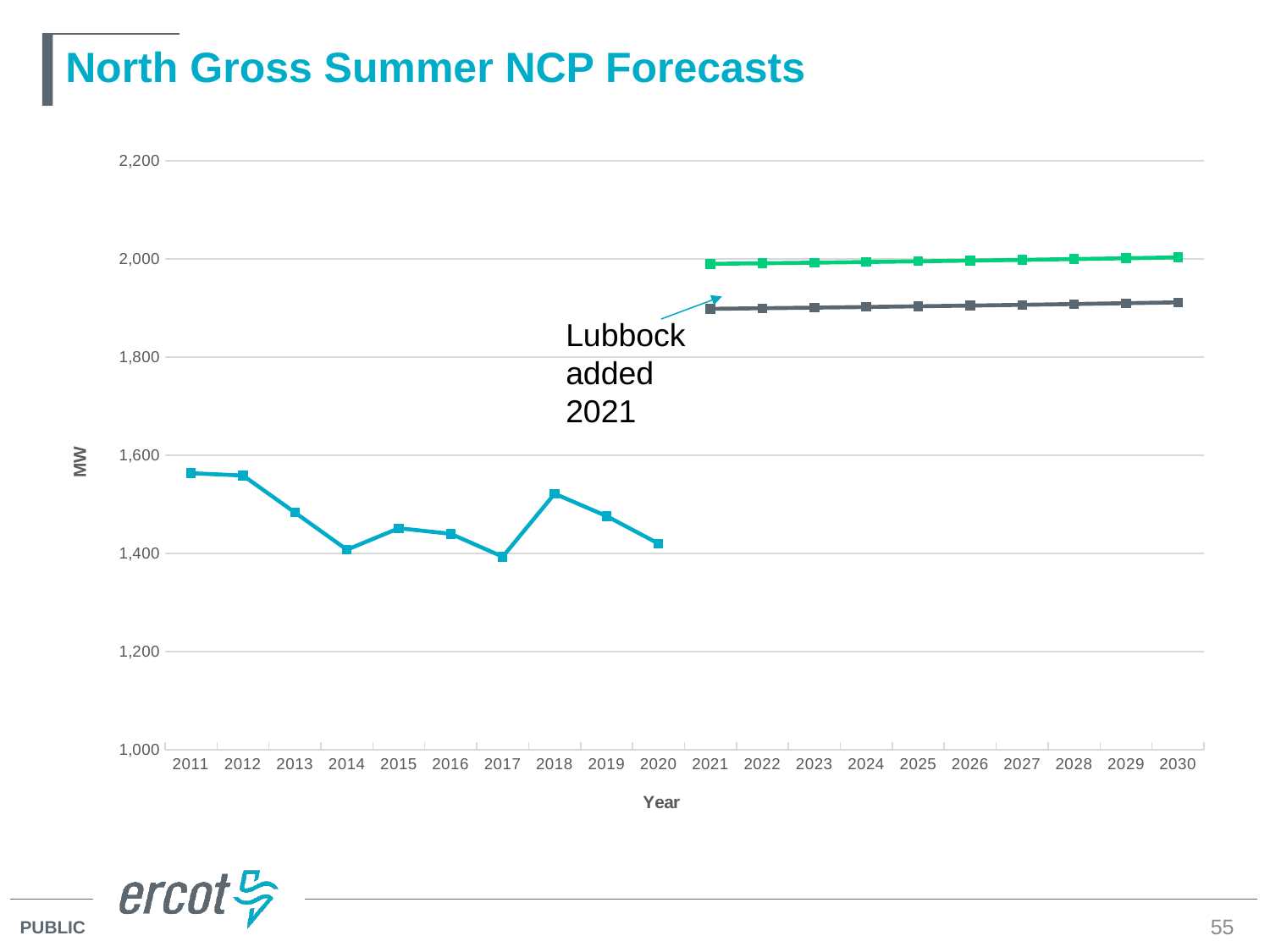
Is the value of the green line for 2030 greater or less than 1,800? greater Which is larger for 2025, the value of the green line or the value of the dark gray line? green line Is the value of the dark gray line for 2021 greater or less than 2,000? less Do the values of the green line rise or fall from 2021 to 2030? rise Which is larger on the blue line, the value for 2018 or the value for 2020? 2018 How many data points does the blue line (2011 to 2020) have? 10 What is the label on the y axis of the chart? MW Is the value of the blue line for 2011 greater or less than 1,400? greater What kind of chart is shown on the slide? line chart How many years are shown on the x axis of the chart? 20 What is the title of the chart? North Gross Summer NCP Forecasts